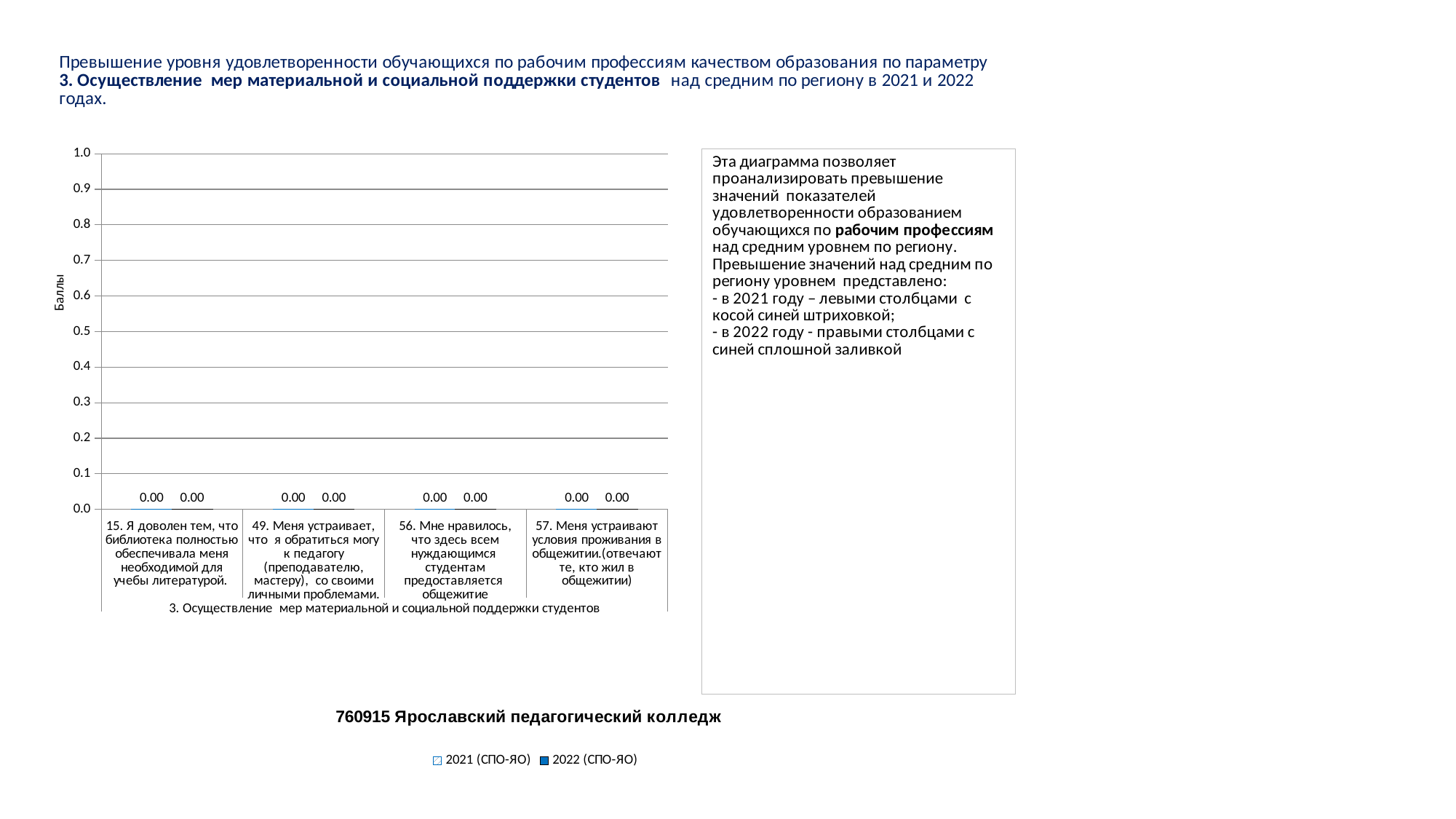
What is the value for 2022 (СПО-ЯО) for category "57. Меня устраивают условия проживания в общежитии.(отвечают те, кто жил в общежитии)"? 0.00 What is the value for 2022 (СПО-ЯО) for category "49. Меня устраивает, что я обратиться могу к педагогу (преподавателю, мастеру), со своими личными проблемами."? 0.00 How many series does the chart legend list? 2 What is the label of the vertical axis of the chart? Баллы What is the value for 2021 (СПО-ЯО) for category "15. Я доволен тем, что библиотека полностью обеспечивала меня необходимой для учебы литературой."? 0.00 Is the value for 2022 (СПО-ЯО) for category "56. Мне нравилось, что здесь всем нуждающимся студентам предоставляется общежитие" greater or less than 0.5? less What is the value for 2021 (СПО-ЯО) for category "56. Мне нравилось, что здесь всем нуждающимся студентам предоставляется общежитие"? 0.00 What kind of chart is shown on the slide? bar chart What are the two series names listed in the chart legend? 2021 (СПО-ЯО) and 2022 (СПО-ЯО) Do the values for 2021 (СПО-ЯО) rise, fall, or stay the same across the categories on the x axis? stay the same What is the difference between the 2021 (СПО-ЯО) and 2022 (СПО-ЯО) values for category "15. Я доволен тем, что библиотека полностью обеспечивала меня необходимой для учебы литературой."? 0.00 How many categories are shown on the x axis of the chart? 4